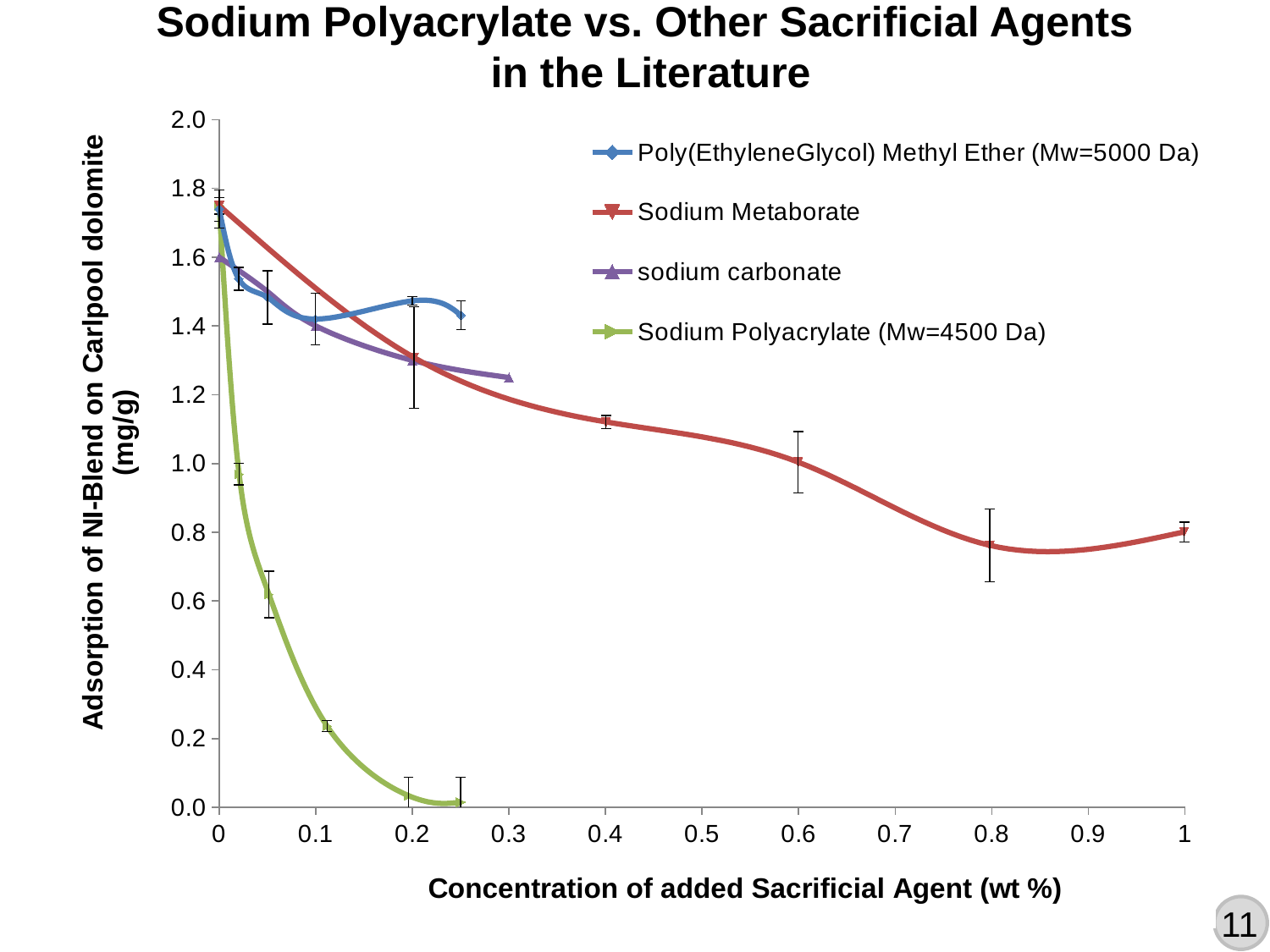
Is the adsorption value for Poly(EthyleneGlycol) Methyl Ether (Mw=5000 Da) at 0.2 wt % greater or less than 1.2? greater Is the adsorption value for Sodium Polyacrylate (Mw=4500 Da) at 0.2 wt % greater or less than 0.2? less Is the adsorption value for Sodium Metaborate at 1 wt % greater or less than 1.0? less What kind of chart is shown on the slide? line chart What is the title of the chart? Sodium Polyacrylate vs. Other Sacrificial Agents in the Literature At 0.2 wt %, which has the larger adsorption: Poly(EthyleneGlycol) Methyl Ether (Mw=5000 Da) or Sodium Polyacrylate (Mw=4500 Da)? Poly(EthyleneGlycol) Methyl Ether (Mw=5000 Da) Which series has the lowest adsorption at 0.2 wt %? Sodium Polyacrylate (Mw=4500 Da) Does the adsorption for Sodium Polyacrylate (Mw=4500 Da) rise or fall as the concentration increases? fall Which series extends to the highest concentration on the x axis? Sodium Metaborate How many series does the legend list? 4 What is the label of the x axis? Concentration of added Sacrificial Agent (wt %)